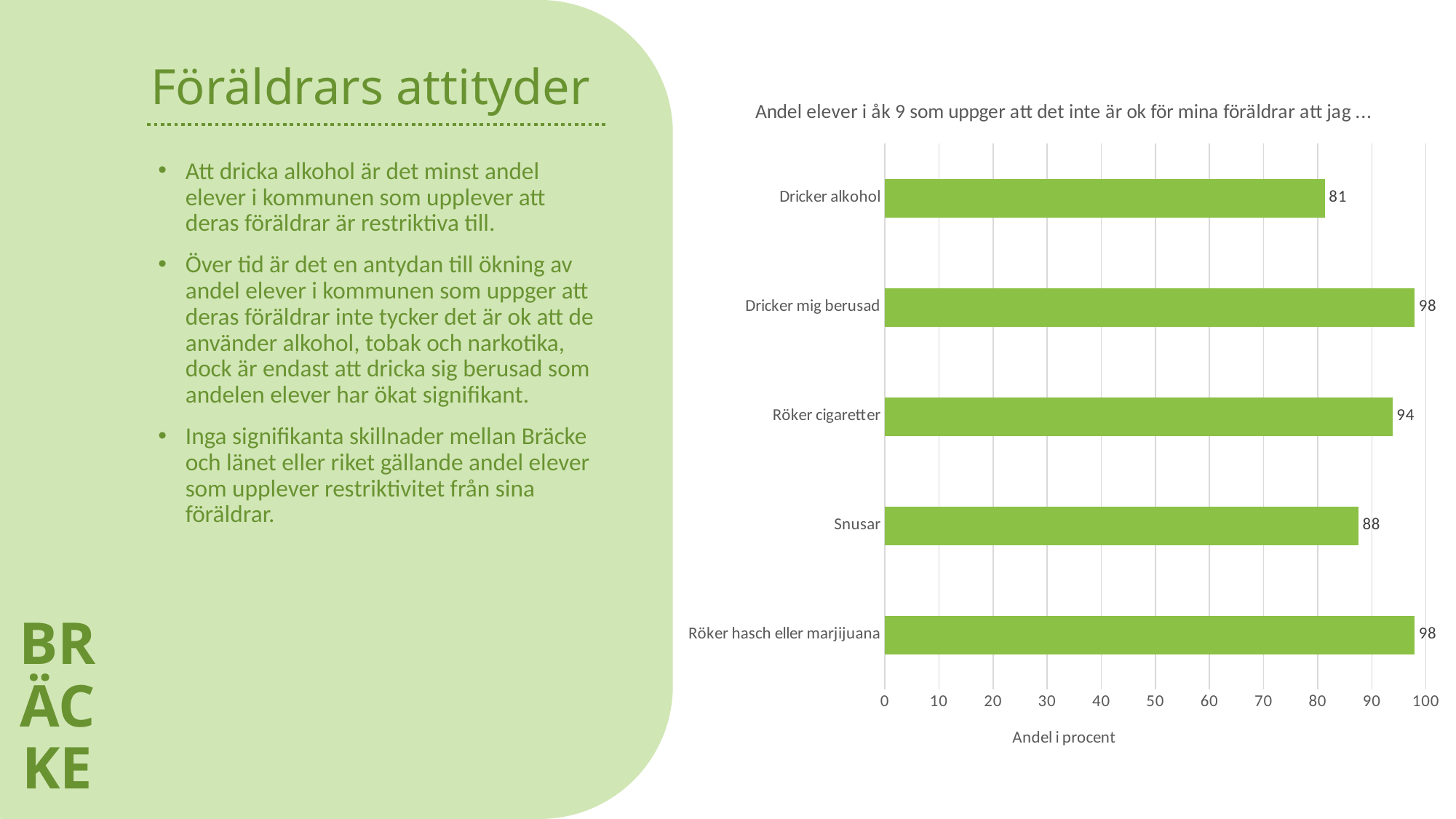
What is the value for Röker cigaretter? 94 How many categories are shown in the chart? 5 What is the difference between the values for Dricker mig berusad and Snusar? 10 Which category has the lowest value? Dricker alkohol What is the value for Dricker mig berusad? 98 What is the label of the horizontal axis? Andel i procent What is the value for Snusar? 88 Is the value for Dricker alkohol greater or less than 90? less Which is larger, the value for Snusar or the value for Röker cigaretter? Röker cigaretter What is the difference between the values for Röker cigaretter and Dricker alkohol? 13 What is the value for Dricker alkohol? 81 What kind of chart is shown on the slide? bar chart